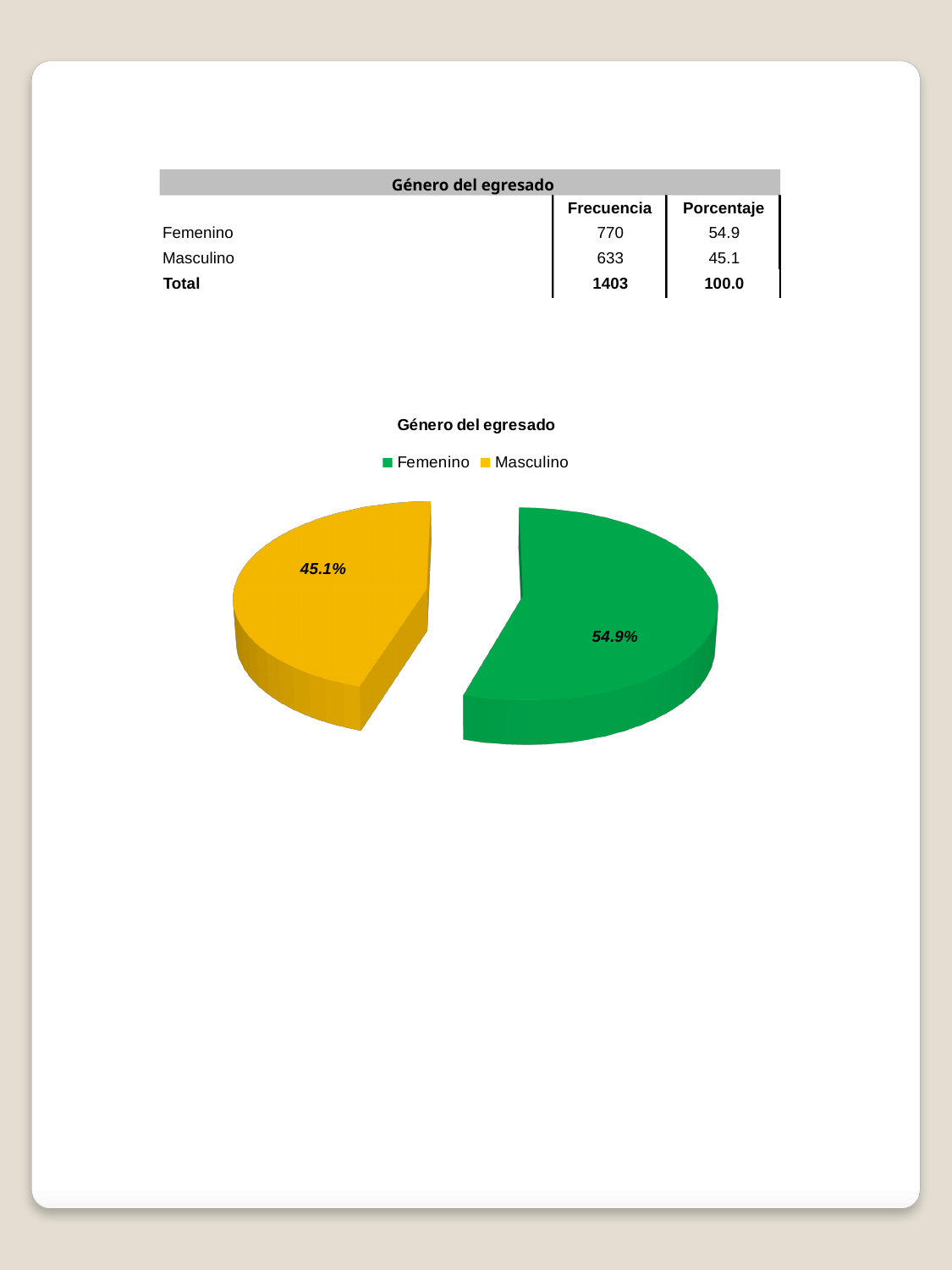
What share of the pie does Femenino represent? 54.9% Which slice is the smallest in the pie chart? Masculino What share of the pie does Masculino represent? 45.1% What is the difference in percentage points between the Femenino and Masculino slices? 9.8 How many series does the chart legend list? 2 Which is larger, the Femenino slice or the Masculino slice? Femenino What is the title of the chart? Género del egresado Which slice is the largest in the pie chart? Femenino What type of chart is shown on the slide? pie chart What colour is the Masculino slice in the pie chart? yellow How many slices does the pie chart have? 2